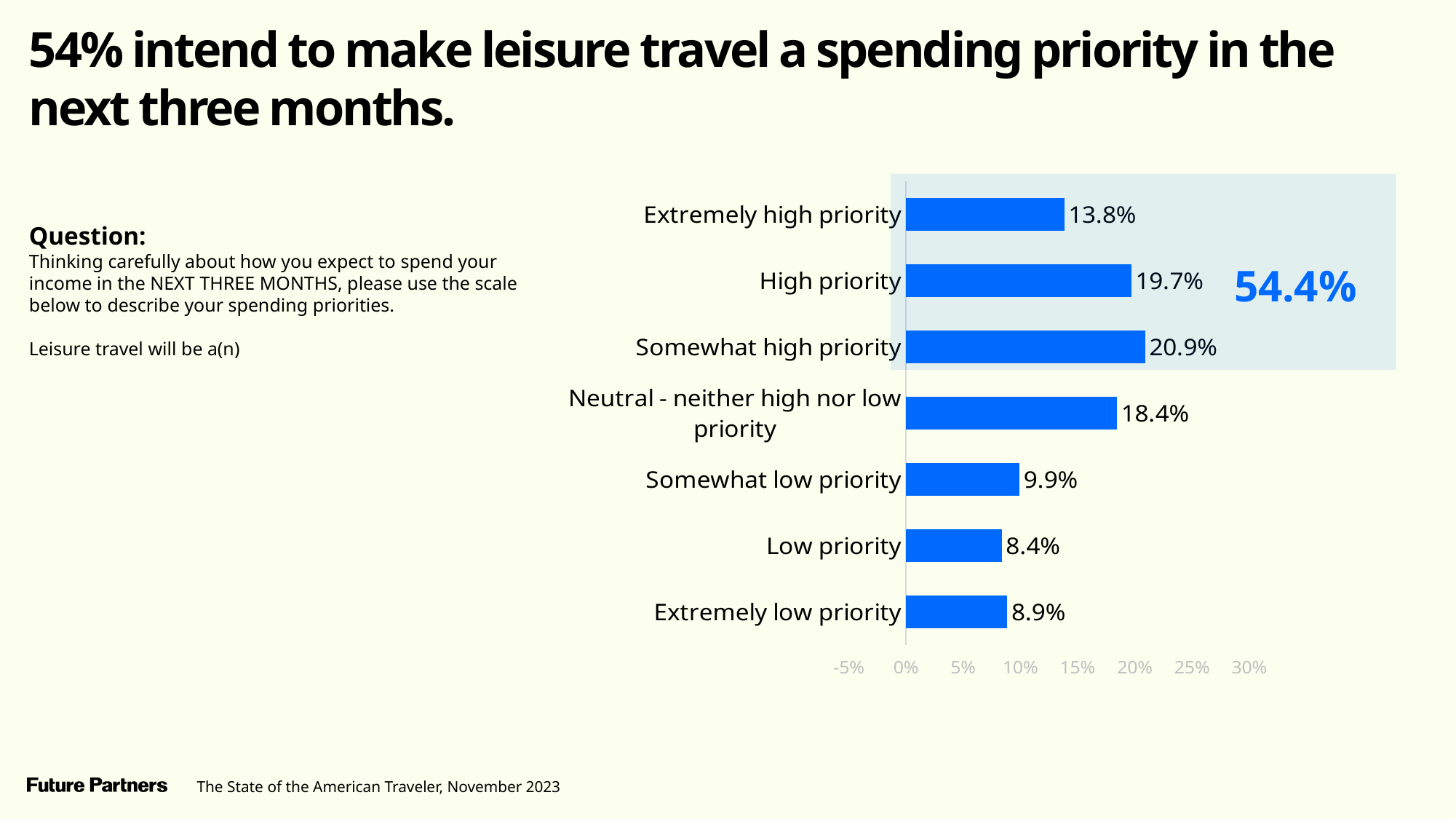
Which is larger, Extremely high priority or Neutral - neither high nor low priority? Neutral - neither high nor low priority What is the value for Neutral - neither high nor low priority? 18.4% What is the total of Extremely high priority, High priority and Somewhat high priority? 54.4% What is the value for Extremely high priority? 13.8% How many categories are shown in the chart? 7 What is the value for Low priority? 8.4% What is the difference between High priority and Somewhat low priority? 9.8% Which category has the lowest value? Low priority What combined percentage is highlighted for the three high-priority categories? 54.4% Which category has the highest value? Somewhat high priority What kind of chart is shown on the slide? Bar chart What is the value for Somewhat high priority? 20.9%